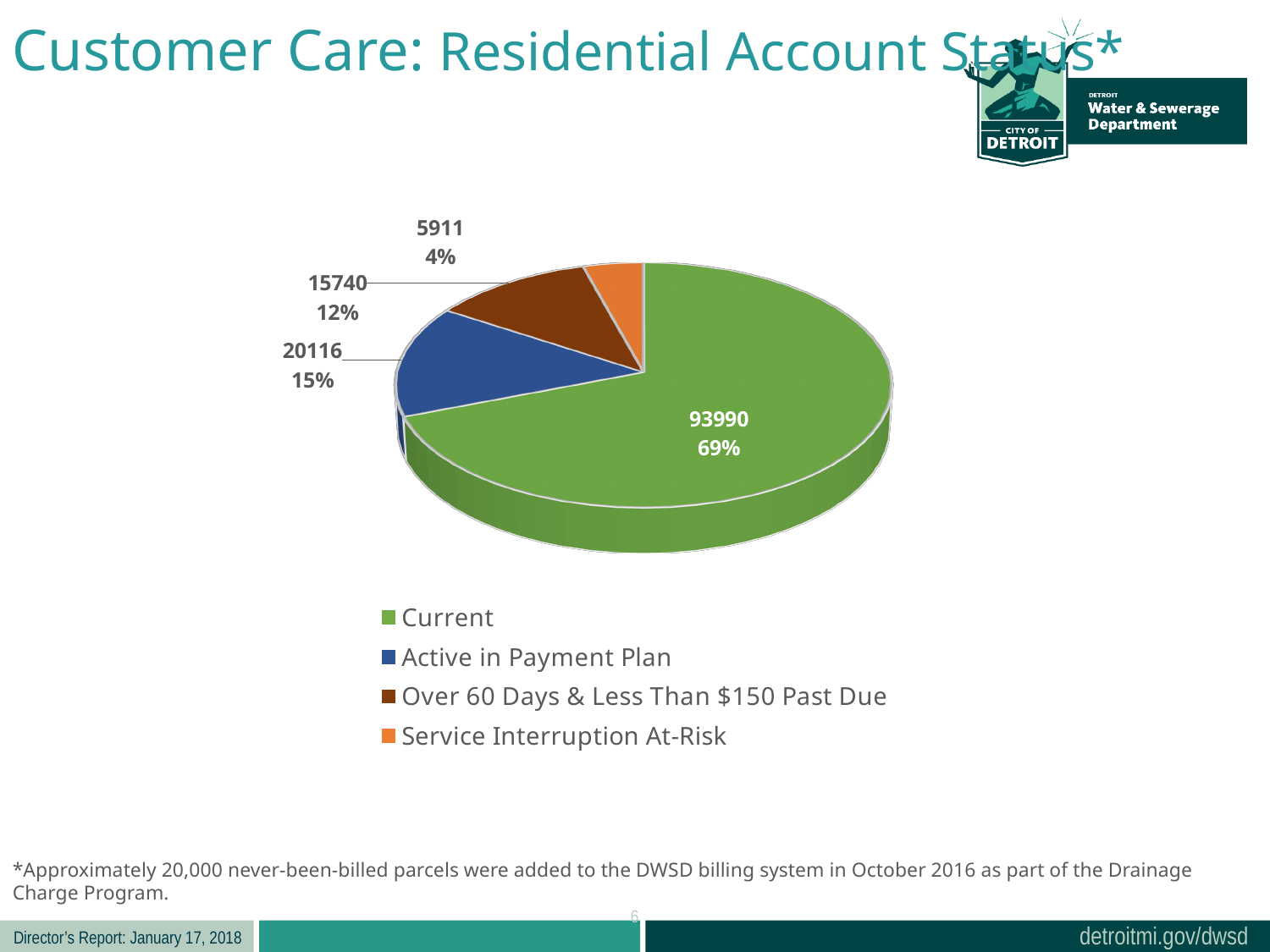
What is the difference between the number of accounts Active in Payment Plan and the number Over 60 Days & Less Than $150 Past Due? 4376 What share of the pie does Service Interruption At-Risk represent? 4% What is the number of accounts Over 60 Days & Less Than $150 Past Due? 15740 What kind of chart is shown on the slide? pie chart What share of the pie does the Current category represent? 69% What is the number of accounts in the Service Interruption At-Risk category? 5911 What is the number of accounts Active in Payment Plan? 20116 Which category has the largest slice of the pie? Current How many entries does the legend list? 4 How many slices does the pie chart have? 4 Which category has the smallest slice of the pie? Service Interruption At-Risk What is the number of accounts in the Current category? 93990